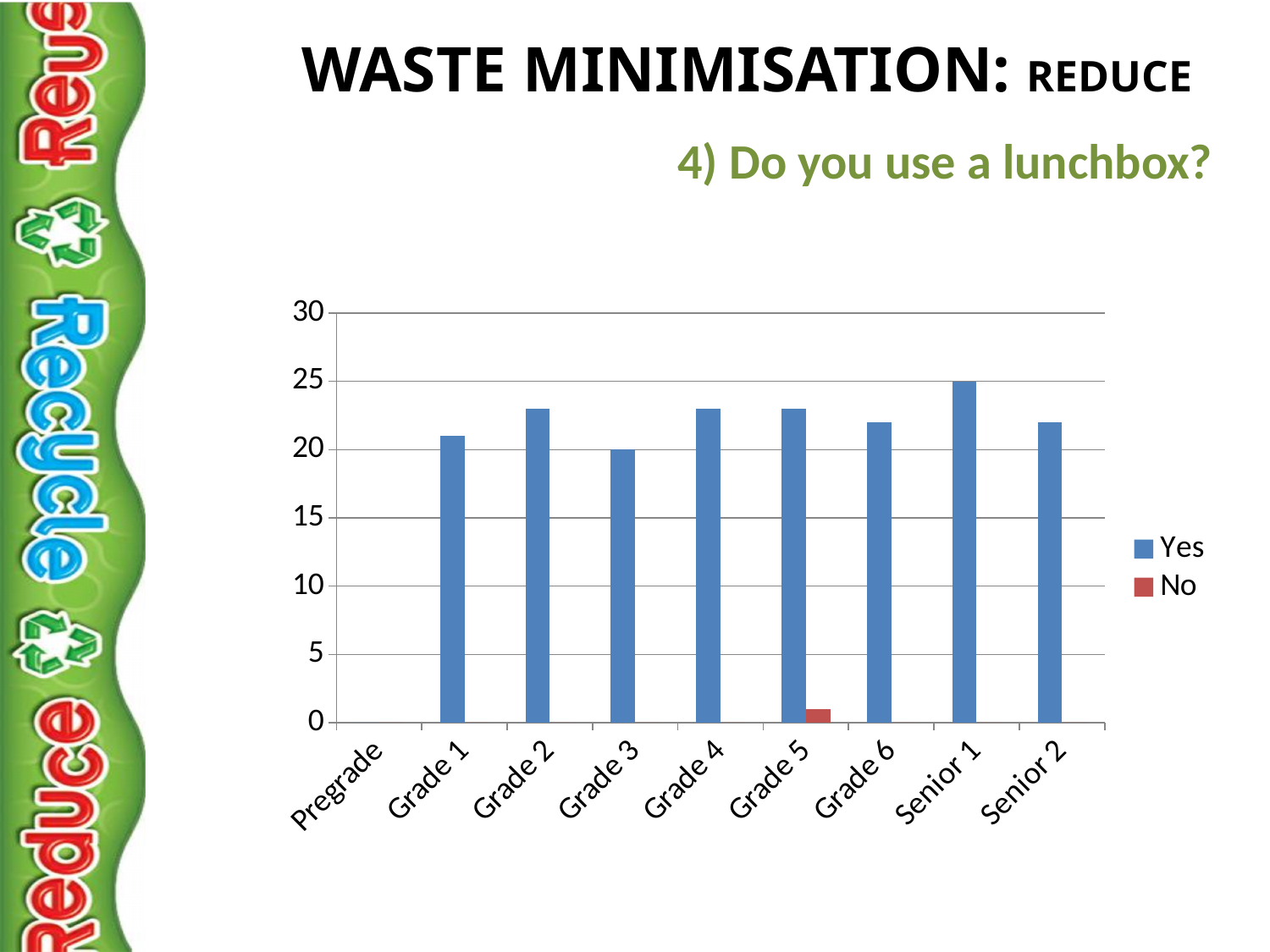
What are the two series named in the legend? Yes and No What kind of chart is shown on the slide? bar chart Is the No value for Grade 5 greater or less than 5? less How many grade categories are shown on the x axis? 9 Which category has the highest Yes value? Senior 1 What is the Yes value for Senior 1? 25 What is the Yes value for Grade 3? 20 What is the title of the chart on the slide? 4) Do you use a lunchbox? For Grade 5, which is larger, the Yes value or the No value? Yes How many series does the legend list? 2 What is the difference between the Yes values for Senior 1 and Grade 3? 5 Is the Yes value for Grade 2 greater or less than 20? greater